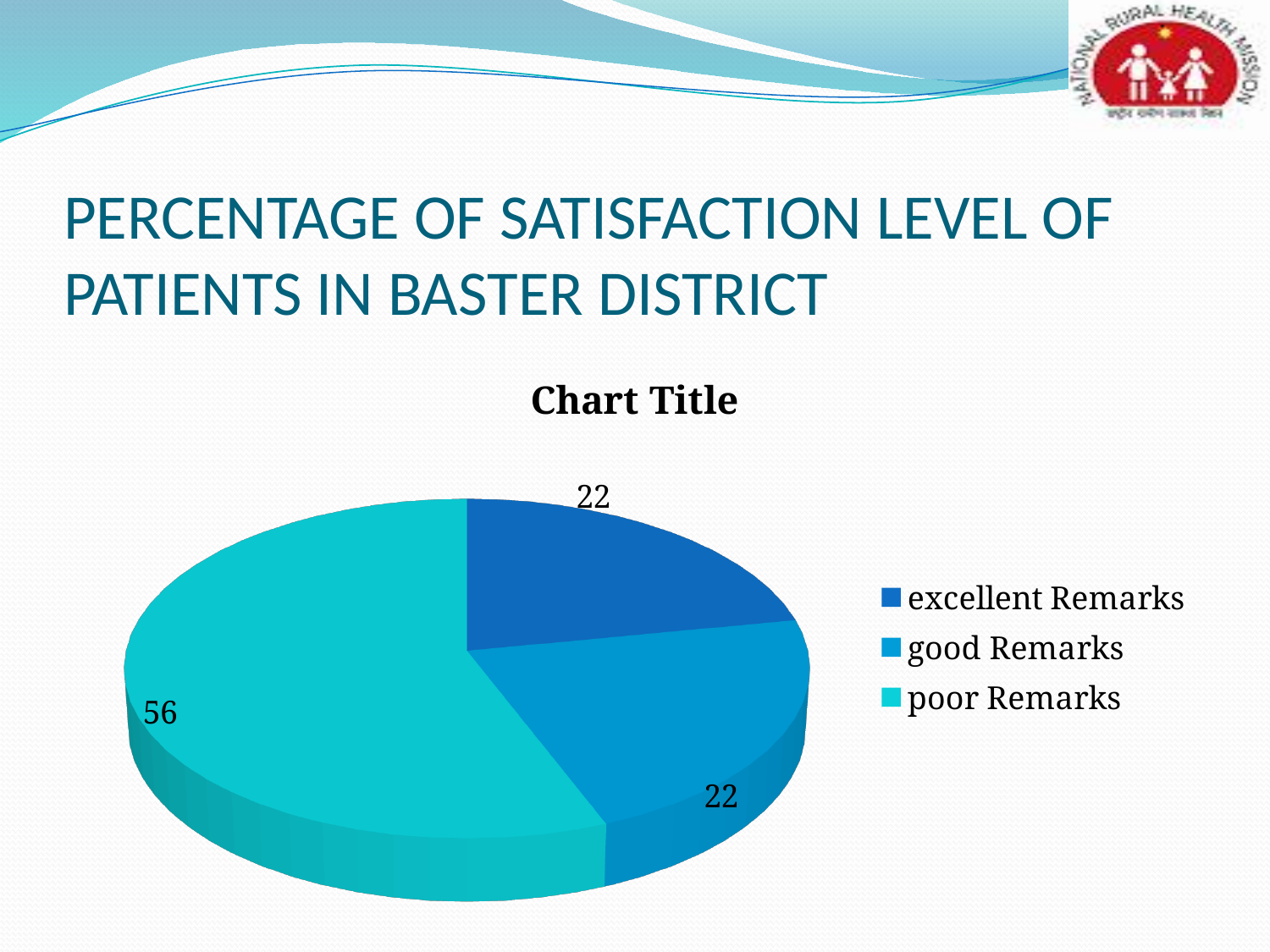
How many slices does the pie chart have? 3 What is the total of all the slice values in the pie chart? 100 Which is larger, the value for poor Remarks or the value for good Remarks? poor Remarks How many entries does the legend list? 3 What is the title printed above the pie chart? Chart Title What kind of chart is shown on the slide? pie chart What is the difference between the values for poor Remarks and excellent Remarks? 34 What is the value for excellent Remarks? 22 What share of the pie does poor Remarks represent? 56% Which category has the largest slice of the pie? poor Remarks What is the value for poor Remarks? 56 What is the value for good Remarks? 22